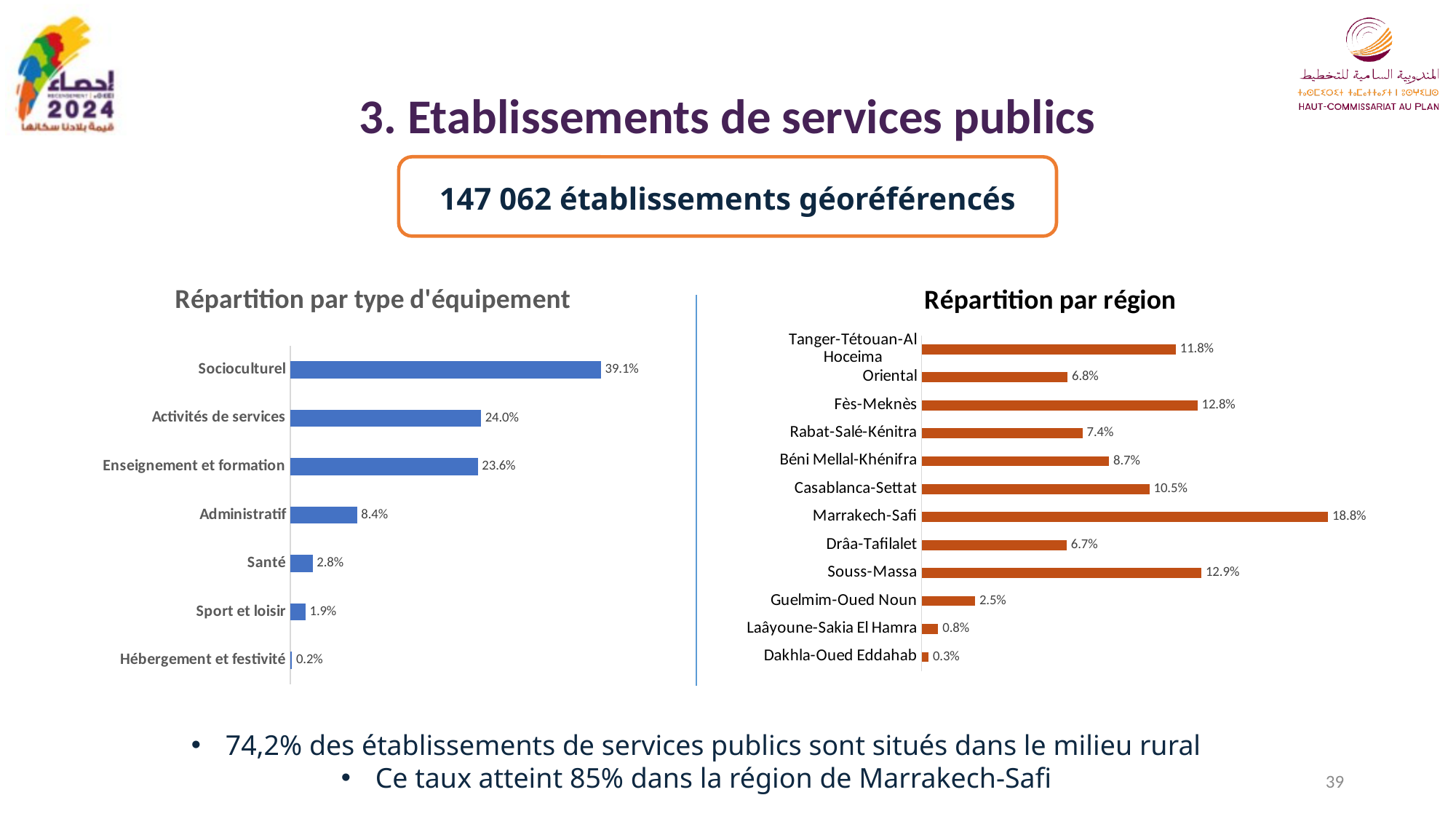
In the 'Répartition par région' chart, what is the value for Casablanca-Settat? 10.5% In the 'Répartition par région' chart, which region has the highest value? Marrakech-Safi In the 'Répartition par région' chart, which is larger: Souss-Massa or Fès-Meknès? Souss-Massa In the 'Répartition par type d'équipement' chart, which category has the lowest value? Hébergement et festivité What type of chart is the 'Répartition par région' chart? Bar chart In the 'Répartition par région' chart, how many regions are shown? 12 In the 'Répartition par région' chart, what is the difference between Marrakech-Safi and Tanger-Tétouan-Al Hoceima? 7.0% In the 'Répartition par type d'équipement' chart, what is the difference between Activités de services and Enseignement et formation? 0.4% In the 'Répartition par type d'équipement' chart, how many categories are shown? 7 In the 'Répartition par région' chart, which region has the lowest value? Dakhla-Oued Eddahab In the 'Répartition par type d'équipement' chart, what is the value for Santé? 2.8% In the 'Répartition par type d'équipement' chart, what is the value for Socioculturel? 39.1%